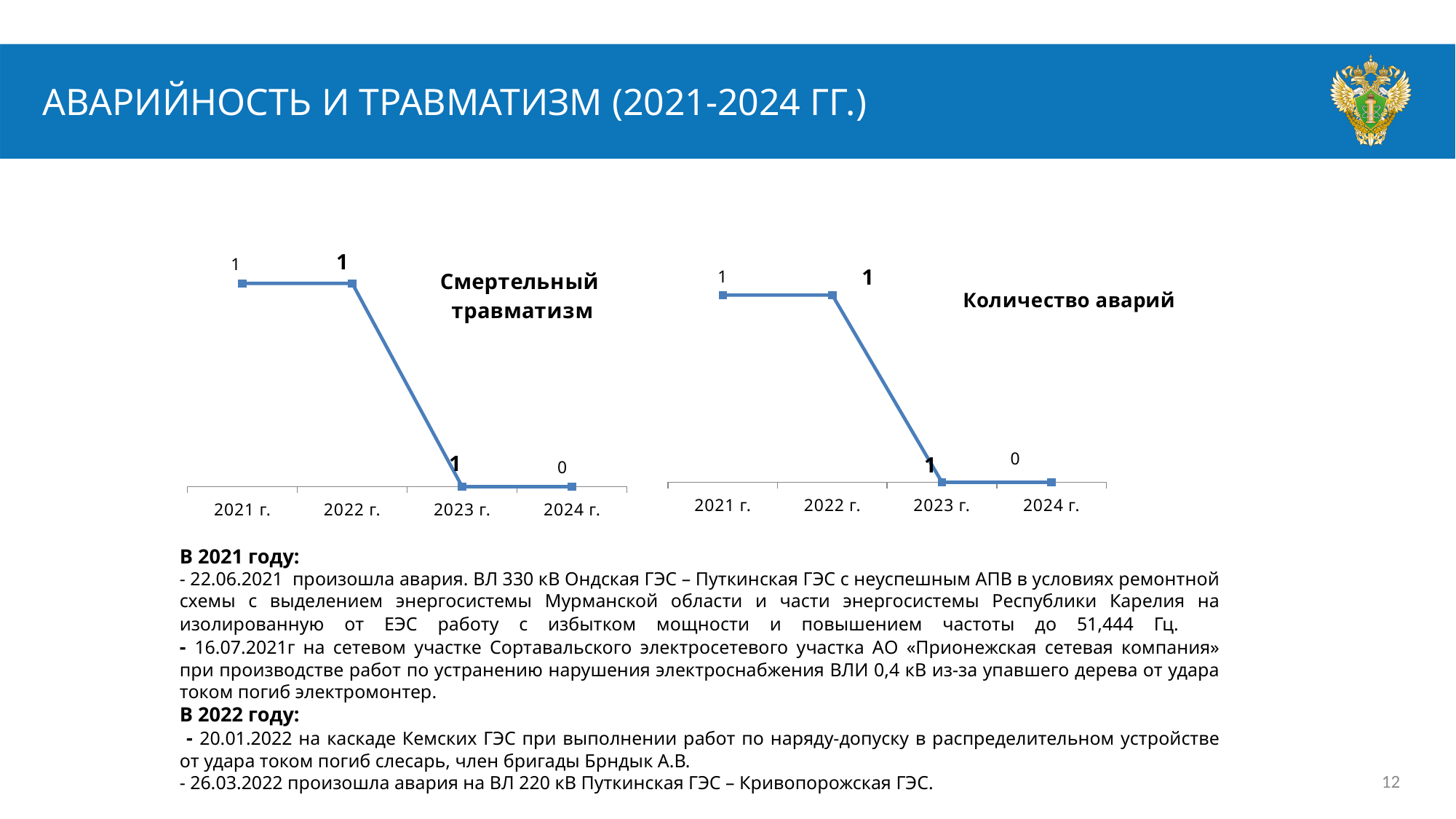
In the chart titled "Количество аварий", what is the difference between the value for 2021 г. and the value for 2024 г.? 1 In the chart titled "Количество аварий", what is the value for 2022 г.? 1 In the chart titled "Смертельный травматизм", what is the value for 2022 г.? 1 In the chart titled "Смертельный травматизм", how many years are plotted along the x axis? 4 What is the title of the chart on the left side of the slide? Смертельный травматизм In the chart titled "Смертельный травматизм", which is larger, the value for 2021 г. or the value for 2024 г.? 2021 г. What is the title of the chart on the right side of the slide? Количество аварий In the chart titled "Количество аварий", do the values rise or fall from 2021 г. to 2024 г.? fall In the chart titled "Смертельный травматизм", what is the value for 2021 г.? 1 What kind of chart is the chart titled "Количество аварий"? line chart In the chart titled "Смертельный травматизм", what is the value for 2024 г.? 0 In the chart titled "Количество аварий", what is the value for 2024 г.? 0